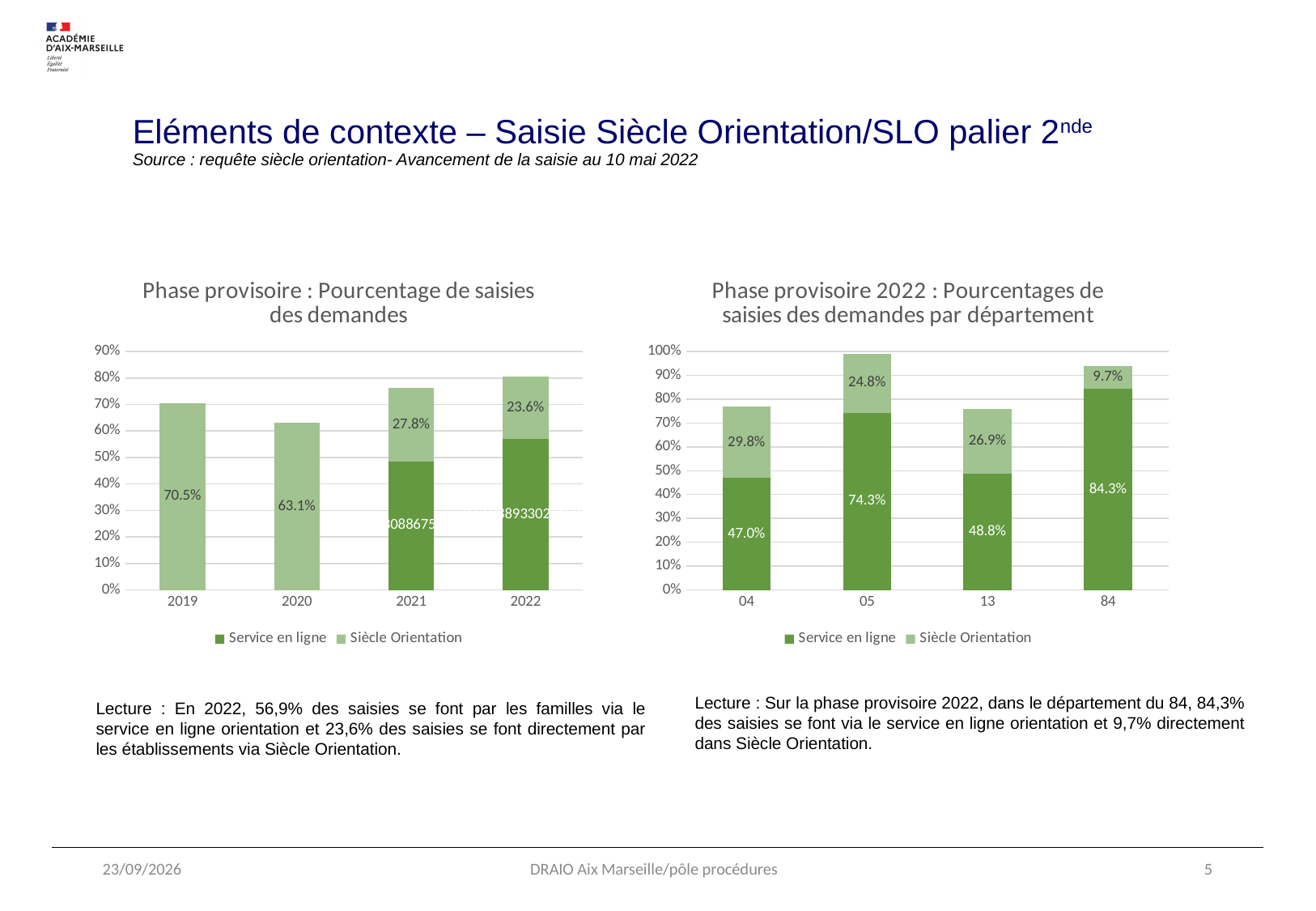
In the chart 'Phase provisoire : Pourcentage de saisies des demandes', what is the Siècle Orientation value for 2019? 70.5% In the chart 'Phase provisoire : Pourcentage de saisies des demandes', does the Siècle Orientation value rise or fall from 2019 to 2022? fall In the chart 'Phase provisoire : Pourcentage de saisies des demandes', which year has the highest Siècle Orientation value? 2019 In the chart 'Phase provisoire 2022 : Pourcentages de saisies des demandes par département', what is the Siècle Orientation value for department 84? 9.7% In the chart 'Phase provisoire : Pourcentage de saisies des demandes', what is the Siècle Orientation value for 2022? 23.6% In the chart 'Phase provisoire 2022 : Pourcentages de saisies des demandes par département', what is the total height of the stacked bar for department 84? 94.0% How many series does the legend of the chart 'Phase provisoire 2022 : Pourcentages de saisies des demandes par département' list? 2 In the chart 'Phase provisoire : Pourcentage de saisies des demandes', how many years are shown on the x axis? 4 In the chart 'Phase provisoire 2022 : Pourcentages de saisies des demandes par département', which department has the lowest Service en ligne value? 04 In the chart 'Phase provisoire : Pourcentage de saisies des demandes', what is the difference between the Siècle Orientation values for 2019 and 2020? 7.4% In the chart 'Phase provisoire 2022 : Pourcentages de saisies des demandes par département', which is larger: the Service en ligne value for department 13 or for department 84? 84 In the chart 'Phase provisoire 2022 : Pourcentages de saisies des demandes par département', what is the Service en ligne value for department 05? 74.3%